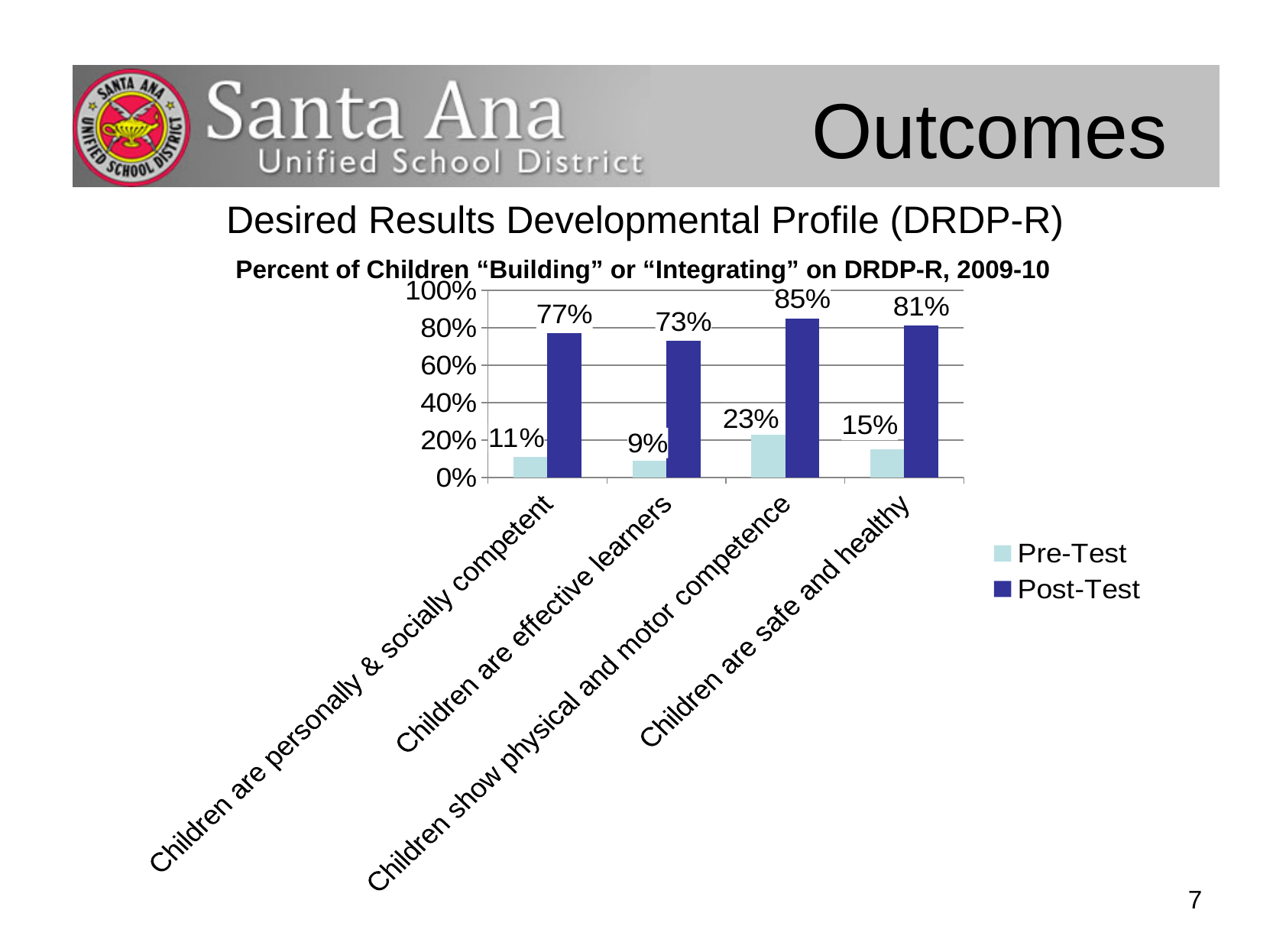
How many categories are shown on the x axis? 4 What is the title of the chart? Percent of Children "Building" or "Integrating" on DRDP-R, 2009-10 What is the Pre-Test value for "Children show physical and motor competence"? 23% What is the difference between the Post-Test and Pre-Test values for "Children are safe and healthy"? 66% Which category has the lowest Pre-Test value? Children are effective learners What is the Pre-Test value for "Children are effective learners"? 9% Which is larger: the Post-Test value for "Children are effective learners" or the Post-Test value for "Children are personally & socially competent"? Children are personally & socially competent What is the Post-Test value for "Children are personally & socially competent"? 77% How many series does the legend list? 2 Which category has the highest Post-Test value? Children show physical and motor competence What kind of chart is shown on the slide? Bar chart What is the Post-Test value for "Children are safe and healthy"? 81%